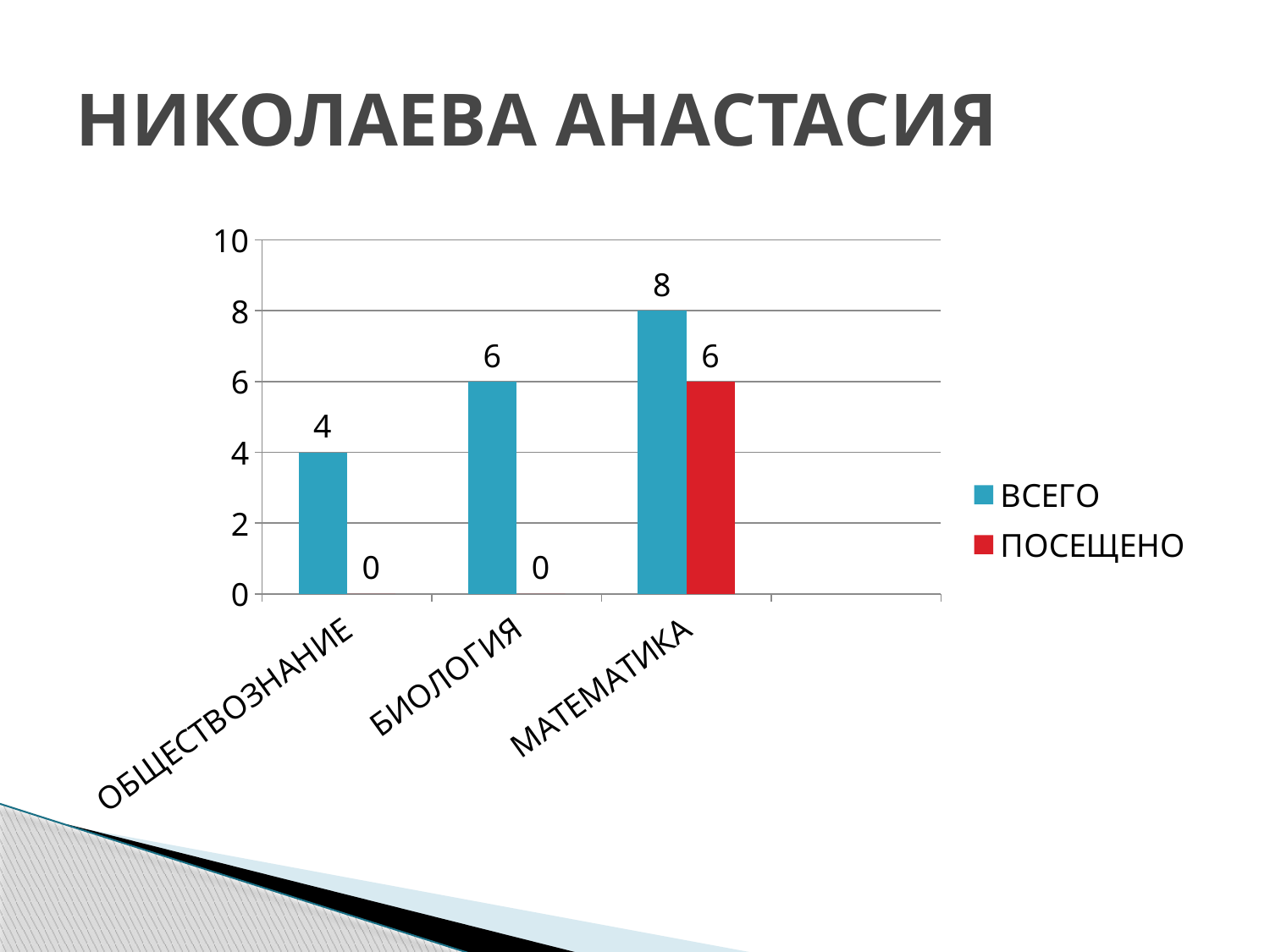
Do the ВСЕГО values rise or fall from ОБЩЕСТВОЗНАНИЕ to МАТЕМАТИКА? rise Which category has the highest ВСЕГО value? МАТЕМАТИКА Which is larger, the ВСЕГО value for БИОЛОГИЯ or the ВСЕГО value for ОБЩЕСТВОЗНАНИЕ? БИОЛОГИЯ How many categories are shown on the x axis? 3 What is the ПОСЕЩЕНО value for БИОЛОГИЯ? 0 What is the ВСЕГО value for ОБЩЕСТВОЗНАНИЕ? 4 What is the difference between the ВСЕГО and ПОСЕЩЕНО values for МАТЕМАТИКА? 2 What is the ПОСЕЩЕНО value for МАТЕМАТИКА? 6 What kind of chart is shown on the slide? bar chart How many series does the legend list? 2 Which category has the lowest ВСЕГО value? ОБЩЕСТВОЗНАНИЕ What is the ВСЕГО value for МАТЕМАТИКА? 8